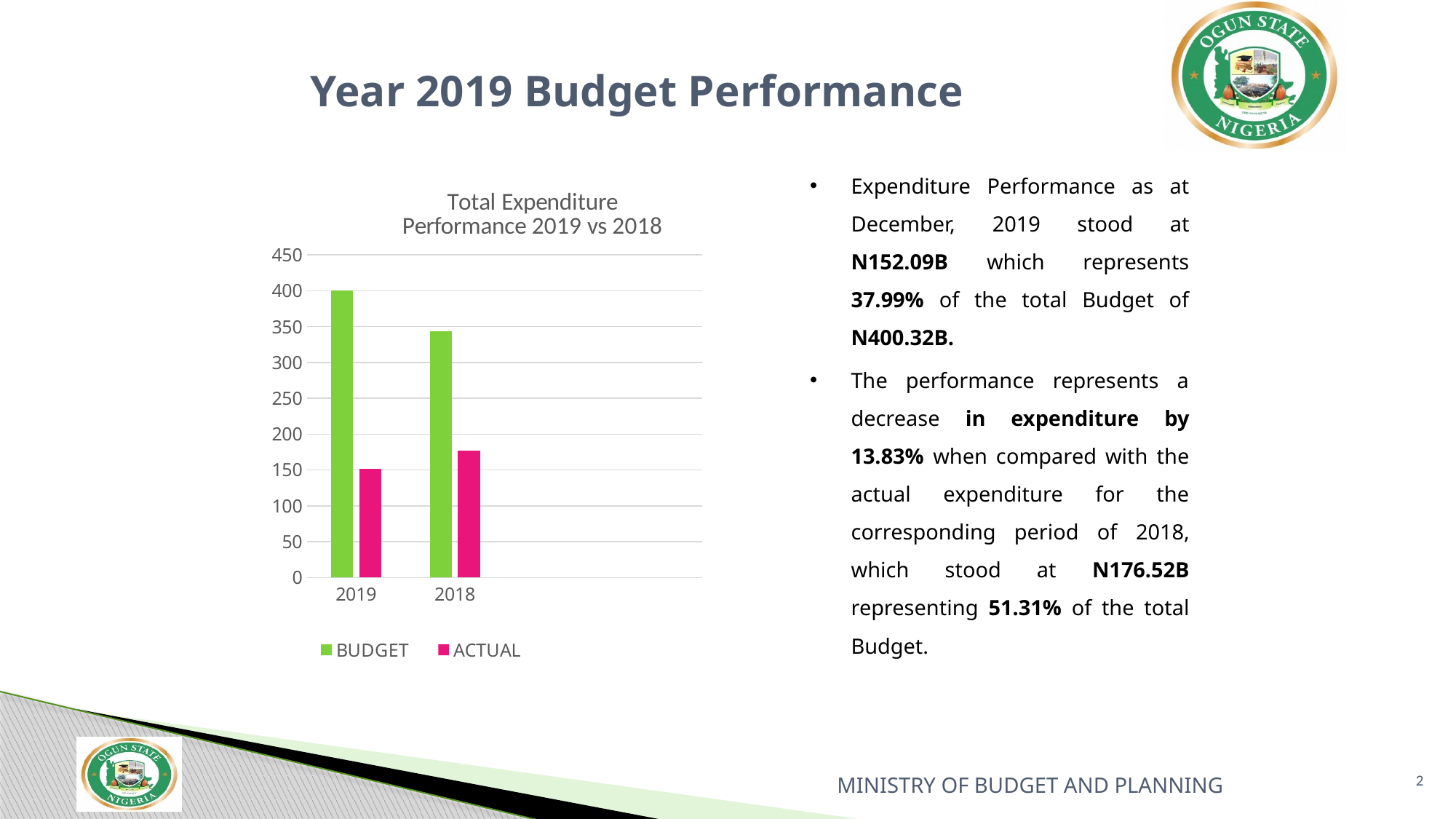
Is the ACTUAL value for 2018 greater or less than 150? greater How many categories are shown on the x axis of the chart? 2 Which bar in the chart is the tallest? BUDGET for 2019 Which is larger, the ACTUAL value for 2018 or the ACTUAL value for 2019? ACTUAL for 2018 Which is larger, the BUDGET value for 2019 or the BUDGET value for 2018? BUDGET for 2019 Which colour represents the ACTUAL series in the chart? pink How many series does the chart legend list? 2 What is the title of the chart? Total Expenditure Performance 2019 vs 2018 Which bar in the chart is the shortest? ACTUAL for 2019 What kind of chart is shown on the slide? bar chart Is the ACTUAL value for 2019 greater or less than 200? less Is the BUDGET value for 2018 greater or less than 300? greater